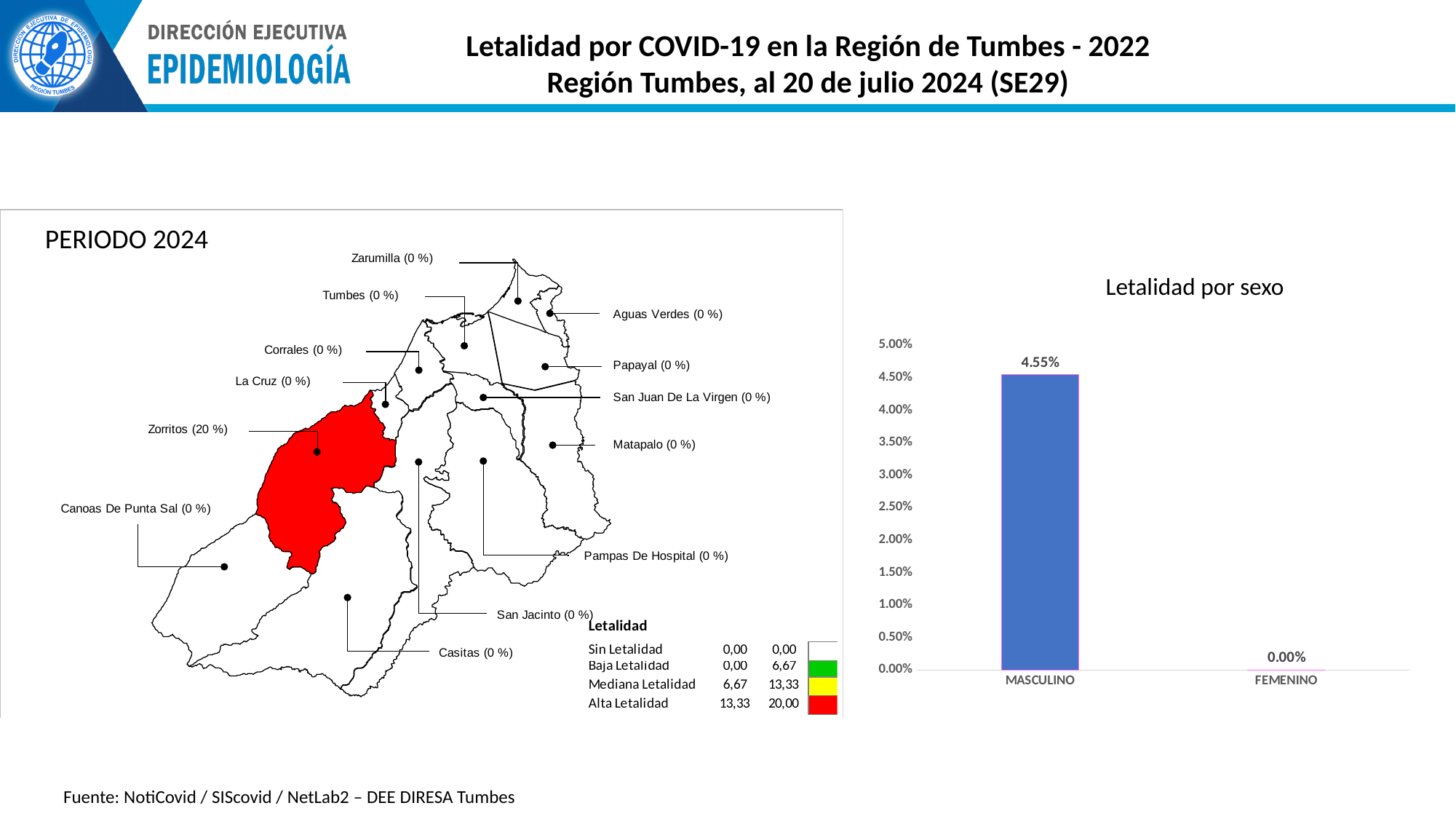
What is the title of the bar chart on the right side of the slide? Letalidad por sexo In the 'Letalidad por sexo' chart, which is larger, the value for MASCULINO or for FEMENINO? MASCULINO In the 'Letalidad por sexo' chart, what is the value for FEMENINO? 0.00% What kind of chart is 'Letalidad por sexo'? bar chart How many categories are shown in the 'Letalidad por sexo' chart? 2 In the 'Letalidad por sexo' chart, which category has the lowest value? FEMENINO In the 'Letalidad por sexo' chart, what is the difference between the MASCULINO and FEMENINO values? 4.55% On the map 'PERIODO 2024', which district is shaded red? Zorritos On the map 'PERIODO 2024', what is the lethality value shown for Zorritos? 20 % In the 'Letalidad por sexo' chart, is the value for MASCULINO greater or less than 4.00%? greater In the 'Letalidad por sexo' chart, what is the value for MASCULINO? 4.55% In the 'Letalidad por sexo' chart, which category has the highest value? MASCULINO